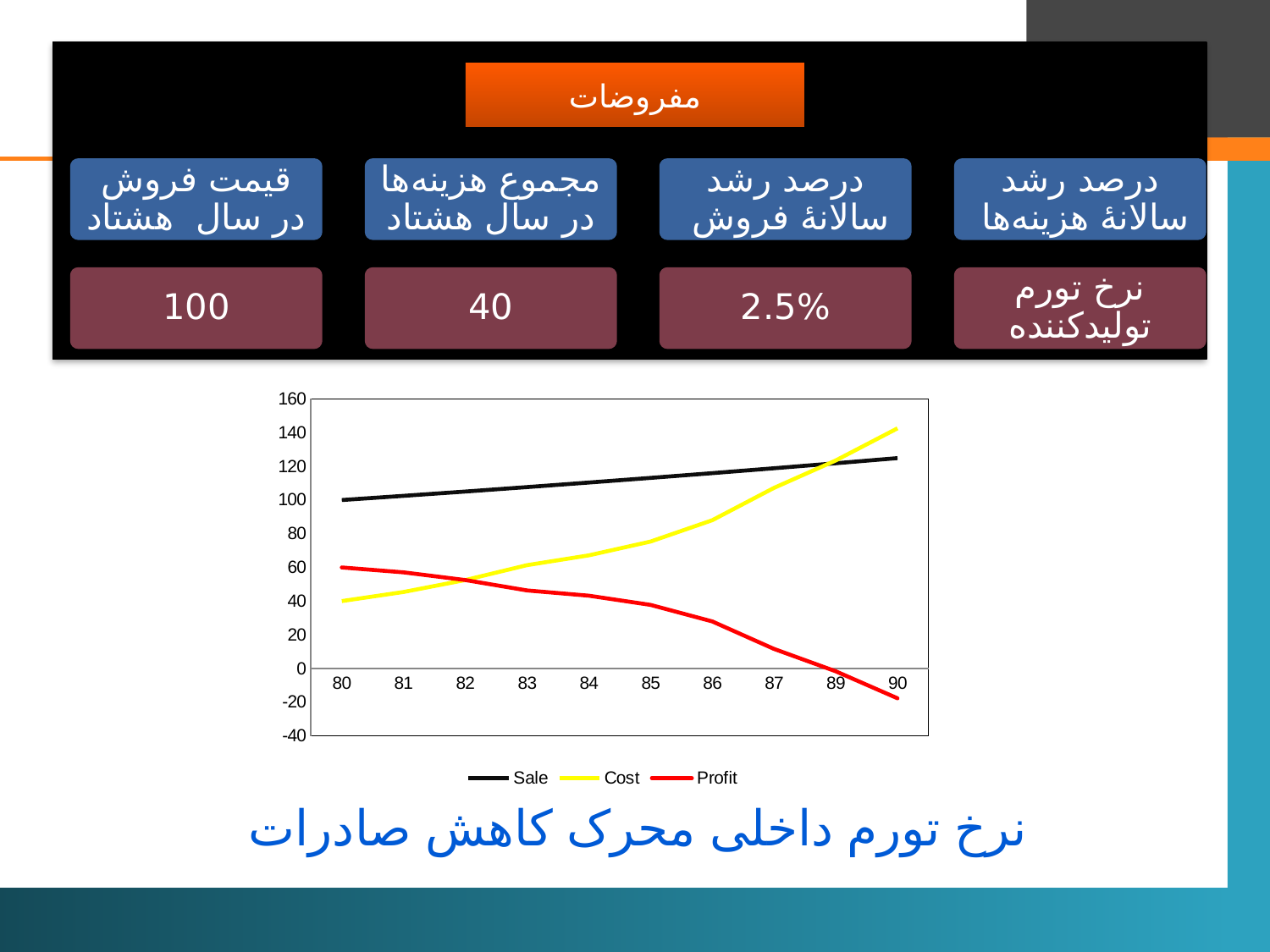
Does the Profit line rise or fall from 80 to 90? fall How many points are labelled along the x axis of the chart? 10 Is the value of Cost at 90 greater or less than 120? greater What is the value of Cost at 80? 40 What is the value of Sale at 80? 100 Is the value of Profit at 90 greater or less than 0? less How many series does the chart legend list? 3 What is the value of Profit at 80? 60 What kind of chart is shown on the slide? line chart What are the series names listed in the chart legend? Sale, Cost, Profit Does the Cost line rise or fall from 80 to 90? rise Which series has the highest value at 90? Cost